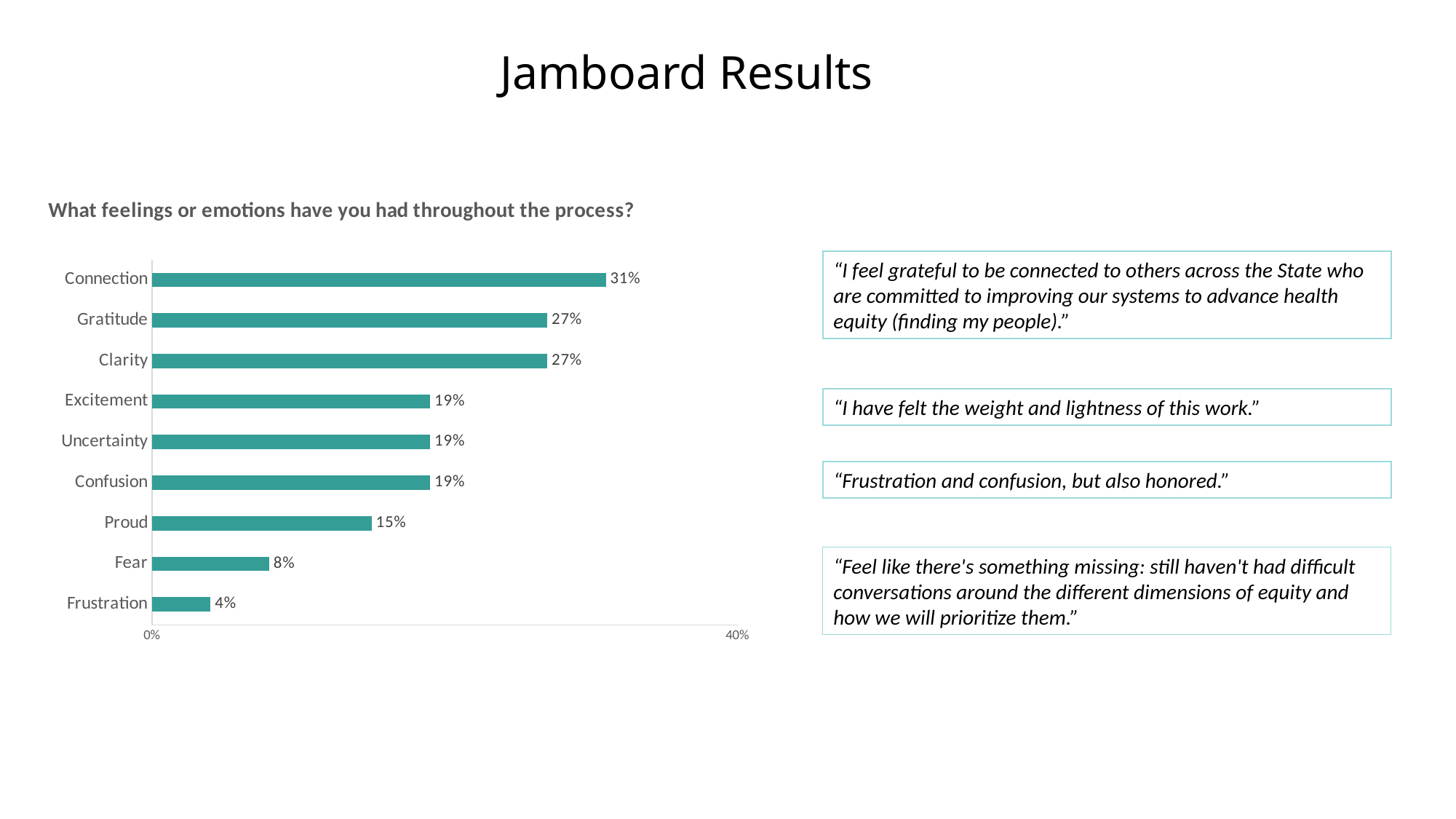
What is the maximum value shown on the horizontal axis? 40% What is the value shown for Proud? 15% What is the difference between the values for Excitement and Fear? 11% Which feeling has the highest percentage? Connection Which feeling has the lowest percentage? Frustration What kind of chart is shown on the slide? Bar chart What question does the chart title ask? What feelings or emotions have you had throughout the process? What is the difference between the values for Connection and Gratitude? 4% What is the value shown for Fear? 8% What percentage of respondents reported feeling Connection? 31% How many feelings or emotions are listed in the chart? 9 Which is larger, the value for Clarity or the value for Uncertainty? Clarity